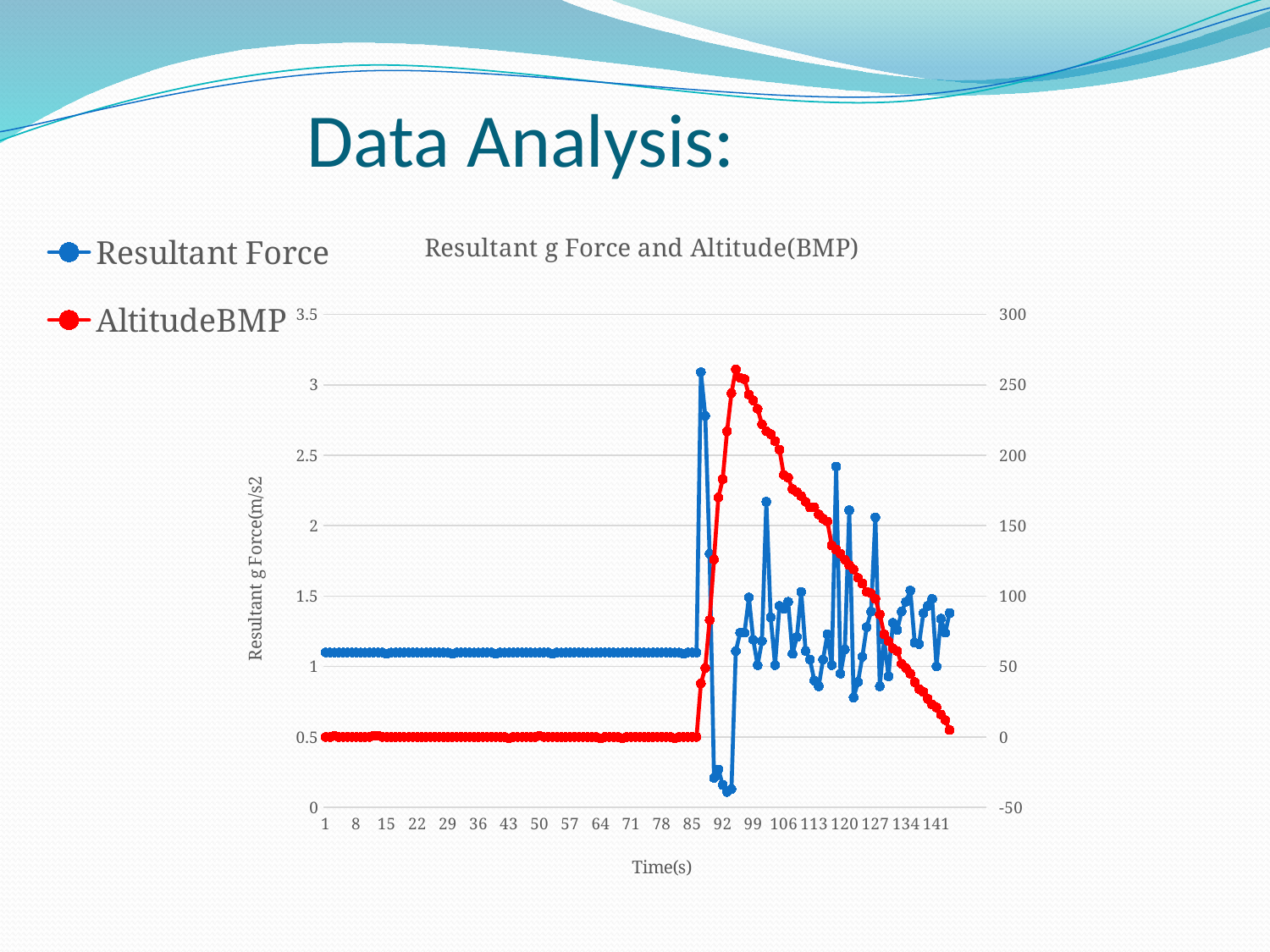
What is the title of the chart? Resultant g Force and Altitude(BMP) How many series does the legend list? 2 After reaching its peak, does the AltitudeBMP series rise or fall as time increases? fall Is the Resultant Force value at time 1 greater or less than 1.5 on the left axis? less What kind of chart is shown on the slide? Line chart What is the label of the x axis? Time(s) Between time 1 and time 78, does the Resultant Force series rise, fall, or stay flat? stay flat Is the peak Resultant Force value greater or less than 2.5 on the left axis? greater Which series reaches its peak first along the time axis, Resultant Force or AltitudeBMP? Resultant Force Is the peak AltitudeBMP value greater or less than 200 on the right axis? greater